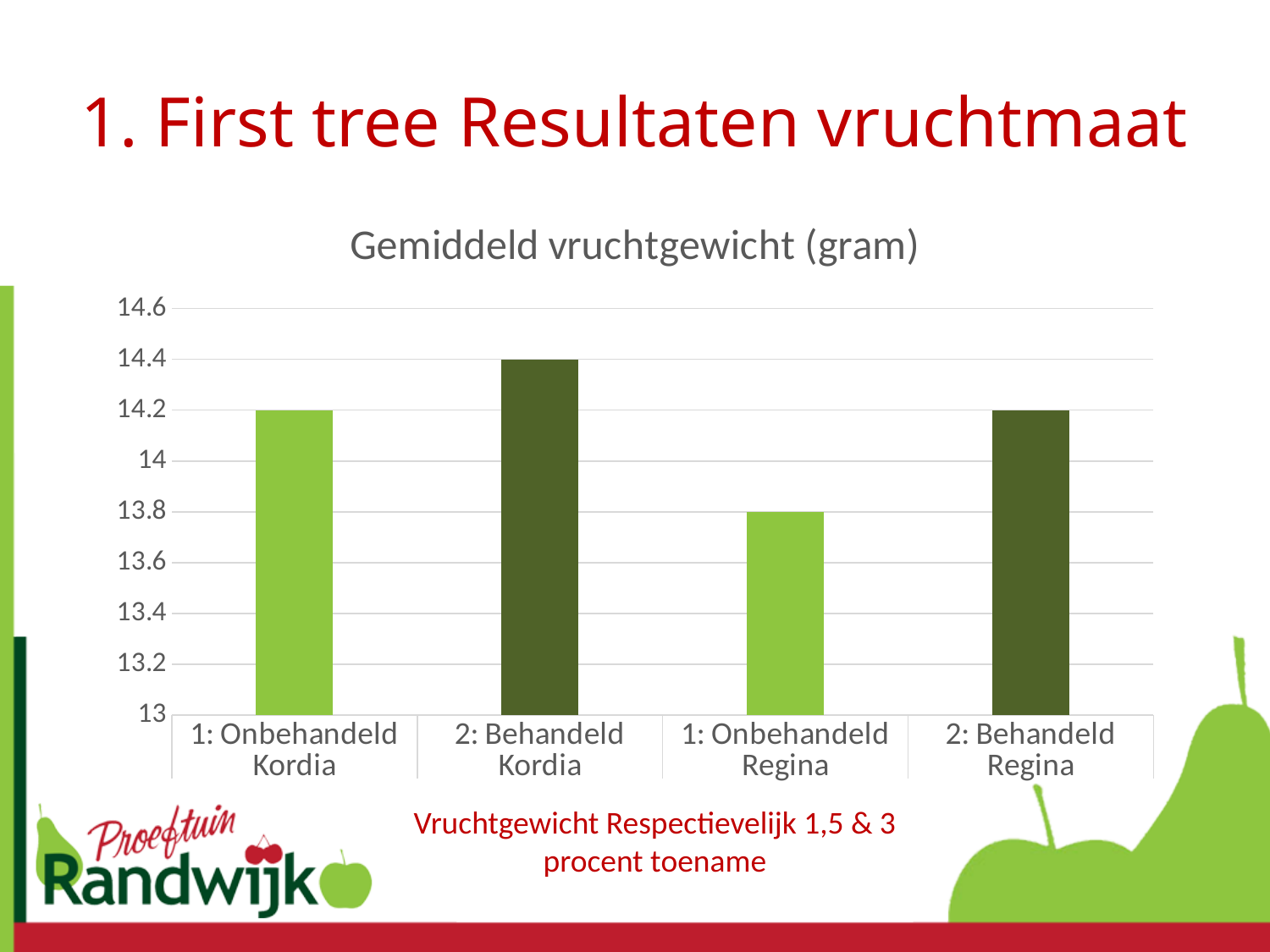
What is the value for 2: Behandeld Kordia? 14.4 Is the value for 1: Onbehandeld Regina greater or less than 14? less What is the difference between 2: Behandeld Regina and 1: Onbehandeld Regina? 0.4 What is the chart title? Gemiddeld vruchtgewicht (gram) Which is larger, the value for 2: Behandeld Regina or 1: Onbehandeld Regina? 2: Behandeld Regina Which category has the highest value? 2: Behandeld Kordia Which category has the lowest value? 1: Onbehandeld Regina What is the value for 1: Onbehandeld Kordia? 14.2 What kind of chart is shown on the slide? bar chart What is the difference between 2: Behandeld Kordia and 1: Onbehandeld Kordia? 0.2 How many categories are plotted in the chart? 4 What is the value for 1: Onbehandeld Regina? 13.8